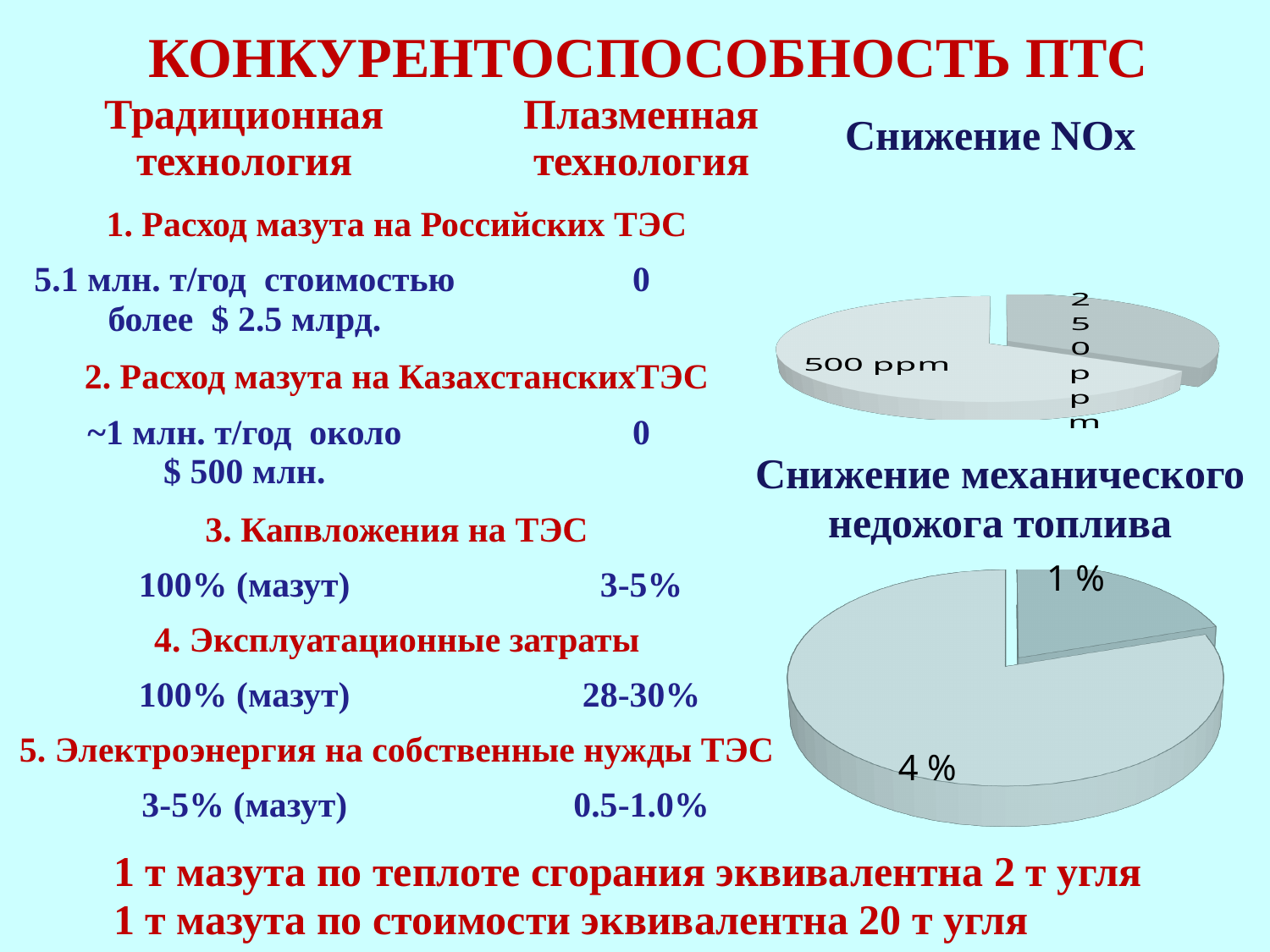
What kind of chart is the "Снижение механического недожога топлива" chart? pie chart In the "Снижение NOx" chart, how many slices does the pie have? 2 In the "Снижение NOx" chart, what is the value of the larger slice? 500 ppm In the "Снижение механического недожога топлива" chart, what is the value of the larger slice? 4 % In the "Снижение NOx" chart, which slice is larger, 500 ppm or 250 ppm? 500 ppm In the "Снижение NOx" chart, what is the difference between the two slice values? 250 ppm What kind of chart is the "Снижение NOx" chart? pie chart What is the title of the lower pie chart on the slide? Снижение механического недожога топлива In the "Снижение механического недожога топлива" chart, what is the difference between the two slice values? 3 % In the "Снижение механического недожога топлива" chart, what is the value of the smaller slice? 1 % In the "Снижение NOx" chart, what is the value of the smaller slice? 250 ppm In the "Снижение механического недожога топлива" chart, how many slices does the pie have? 2